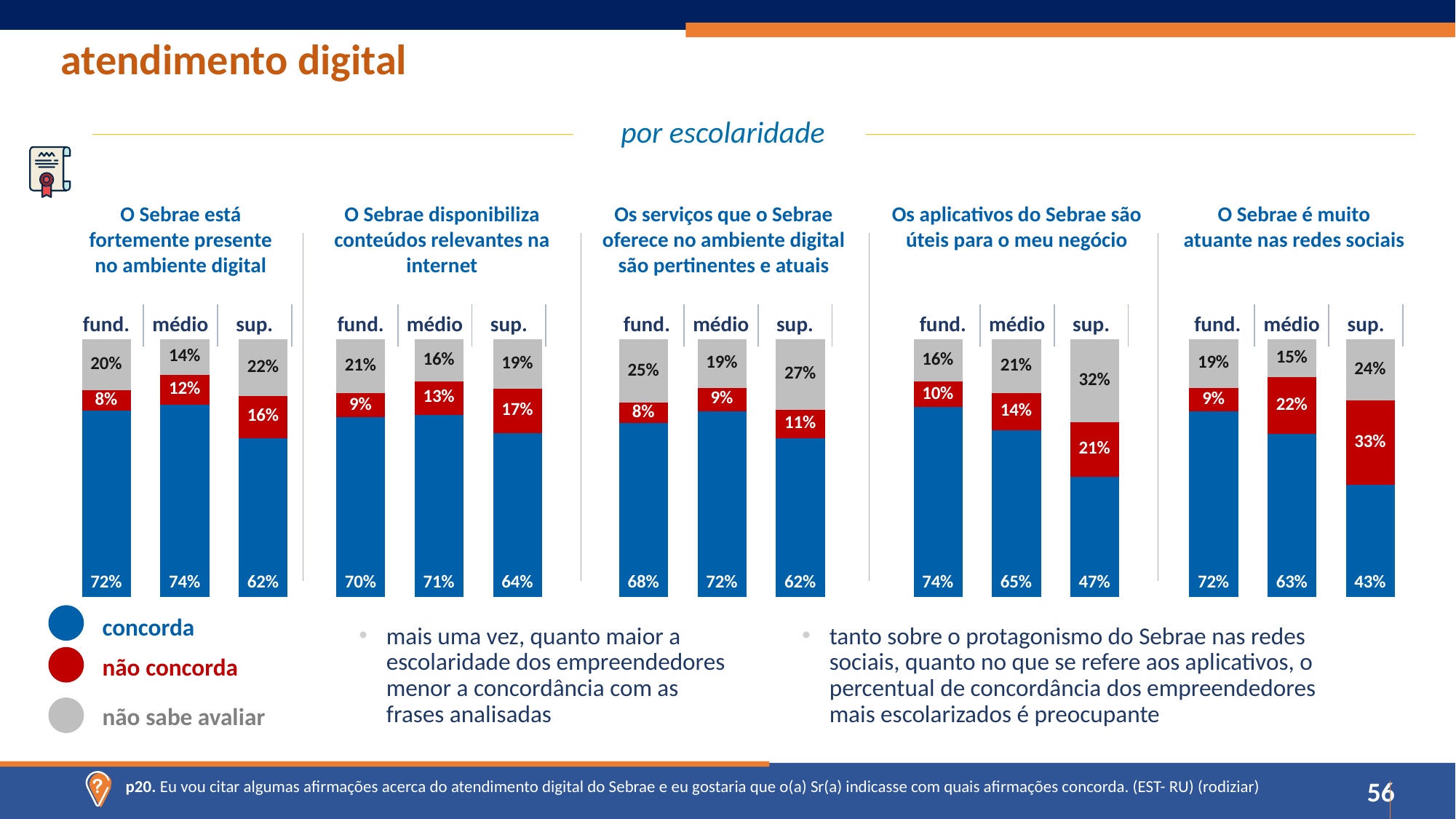
In the chart 'Os aplicativos do Sebrae são úteis para o meu negócio', what is the 'não concorda' value for sup.? 21% How many series does the legend list? 3 In the chart 'O Sebrae é muito atuante nas redes sociais', which education level has the lowest 'concorda' value? sup. In the chart 'O Sebrae é muito atuante nas redes sociais', which is larger: the 'não concorda' value for médio or for sup.? sup. In the chart 'Os aplicativos do Sebrae são úteis para o meu negócio', do the 'concorda' values rise or fall from fund. to sup.? Fall What kind of chart is used on this slide? Stacked bar chart In the chart 'O Sebrae está fortemente presente no ambiente digital', what is the 'concorda' value for fund.? 72% In the chart 'Os aplicativos do Sebrae são úteis para o meu negócio', what is the total of the stacked bar for sup.? 100% Which colour represents 'não concorda' in the legend? Red How many education-level categories does each chart show? 3 In the chart 'Os serviços que o Sebrae oferece no ambiente digital são pertinentes e atuais', what is the difference between the 'concorda' values for médio and sup.? 10% In the chart 'O Sebrae disponibiliza conteúdos relevantes na internet', which education level has the highest 'não sabe avaliar' value? fund.